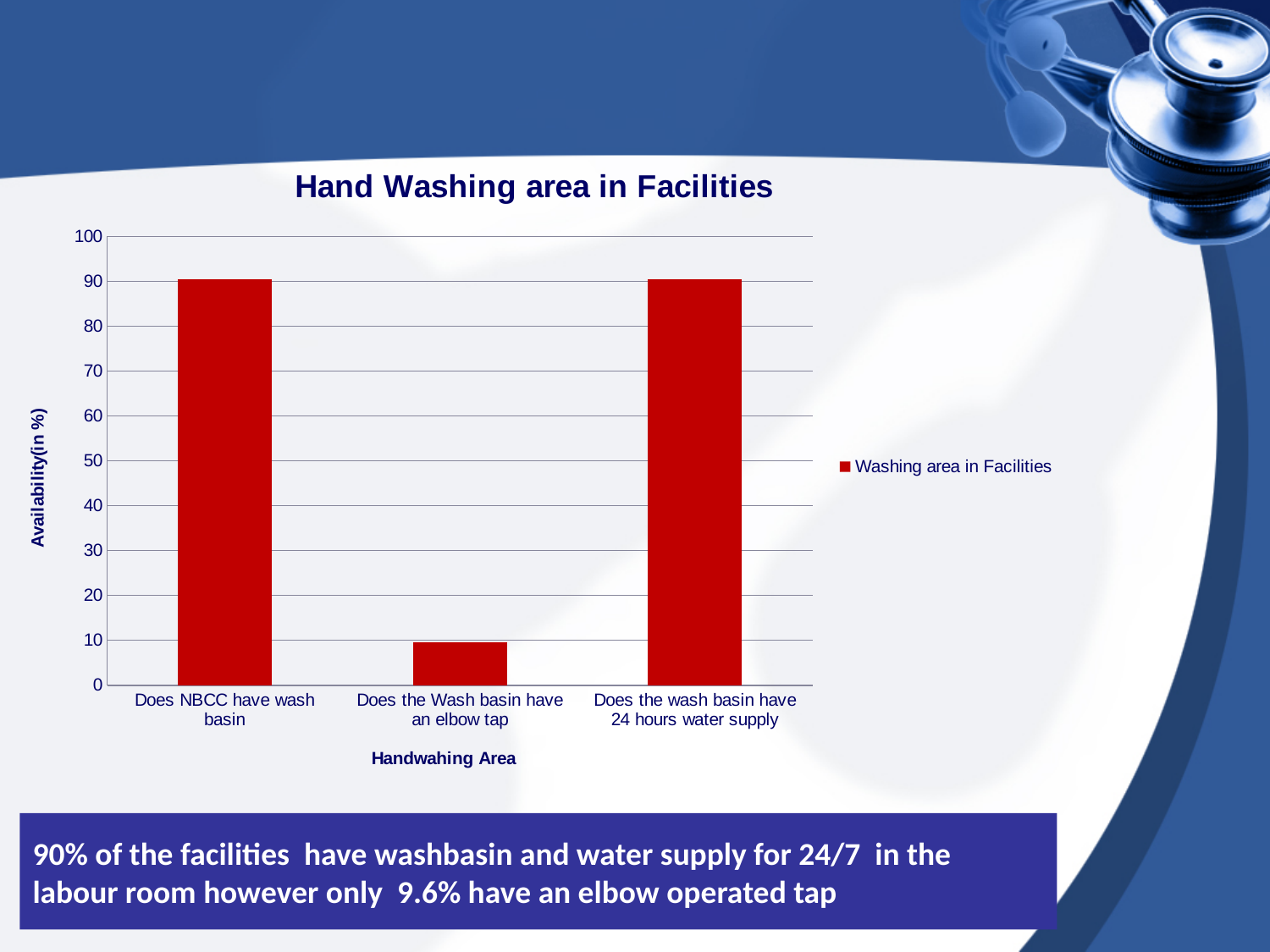
Is the value for "Does the wash basin have 24 hours water supply" greater or less than 80? greater What is the title of the chart? Hand Washing area in Facilities What is the label of the vertical axis of the chart? Availability(in %) How many categories are shown on the x axis of the chart? 3 How many series does the chart legend list? 1 Which is larger: the value for "Does the Wash basin have an elbow tap" or the value for "Does the wash basin have 24 hours water supply"? Does the wash basin have 24 hours water supply Which is larger: the value for "Does NBCC have wash basin" or the value for "Does the Wash basin have an elbow tap"? Does NBCC have wash basin Which category has the lowest value in the chart? Does the Wash basin have an elbow tap What kind of chart is shown on the slide? bar chart